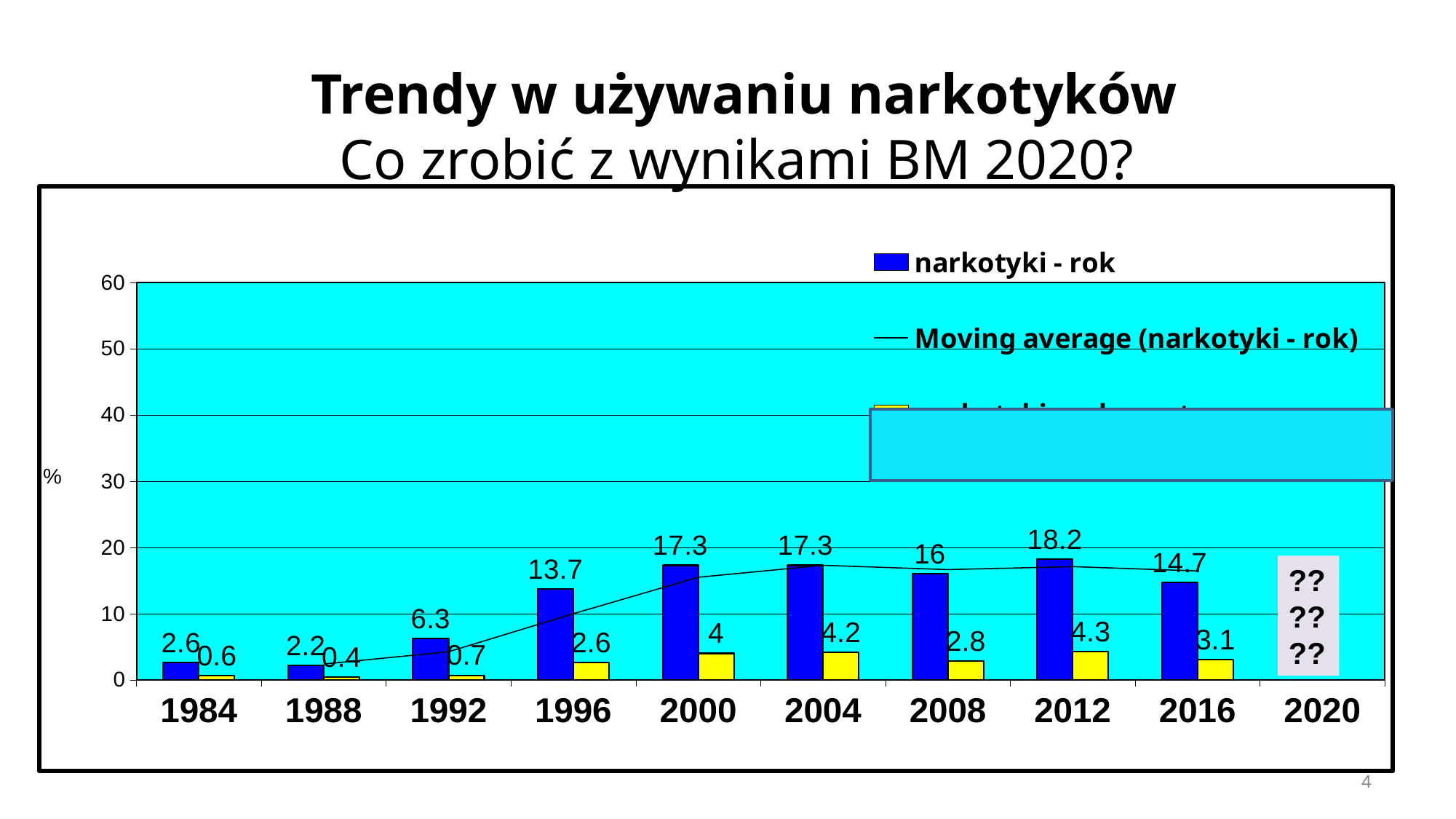
What is the value of the yellow bar for 2004? 4.2 How many years are shown on the x axis? 10 What is the value of the narkotyki - rok bar for 2012? 18.2 What is shown in place of the bars for 2020? ?? What is the difference between the narkotyki - rok values for 2012 and 2016? 3.5 What is the value of the narkotyki - rok bar for 1996? 13.7 What kind of chart is shown on the slide? bar chart Is the narkotyki - rok value for 2000 greater or less than 10? greater Which year has the lowest narkotyki - rok value? 1988 Do the narkotyki - rok values rise or fall from 1988 to 2000? rise Which year has the larger narkotyki - rok value, 2008 or 2016? 2008 Which year has the highest narkotyki - rok value? 2012